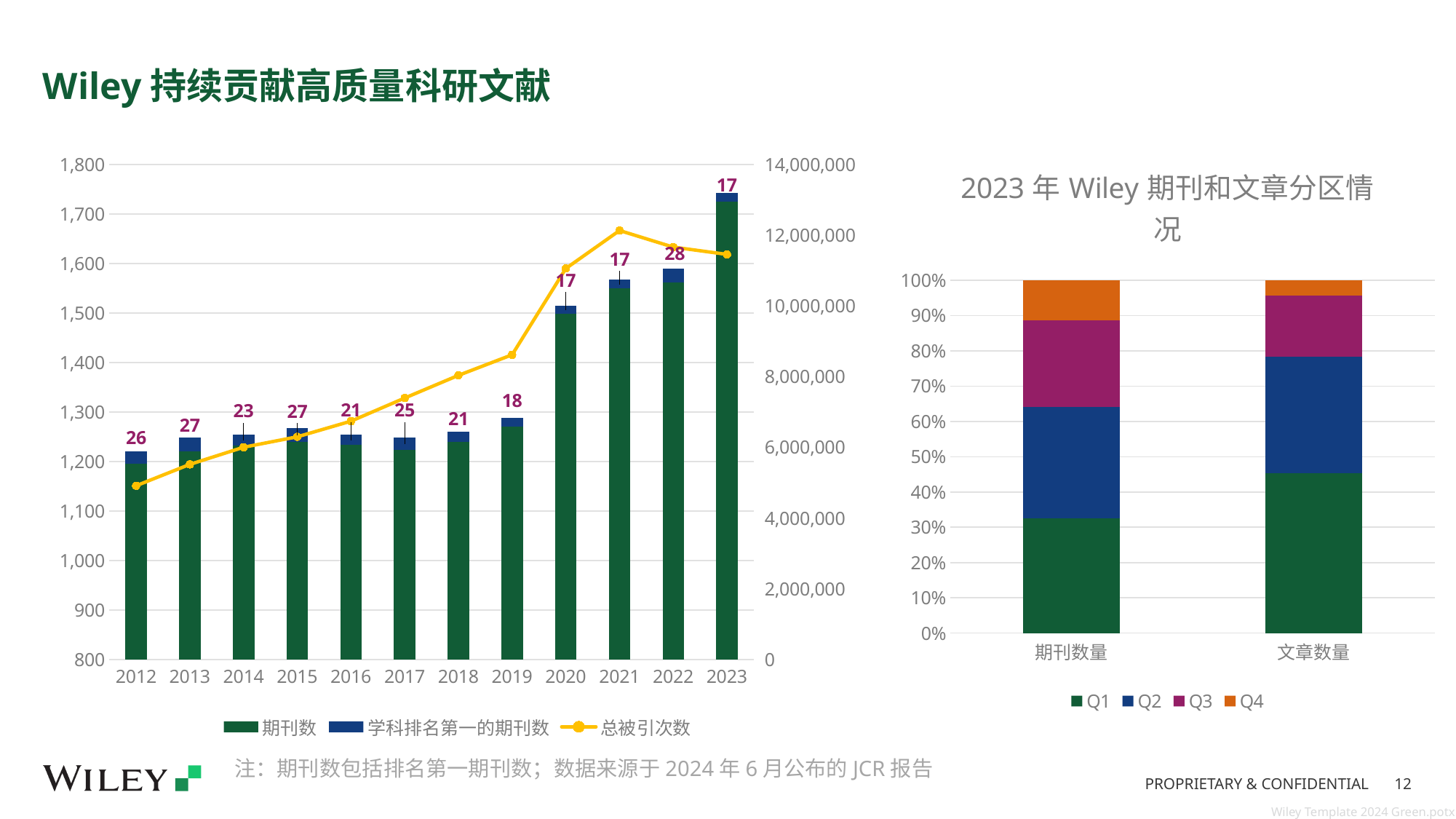
In the left chart, which year has the larger labelled value, 2013 or 2016? 2013 How many series does the legend of the left chart list? 3 In the left chart, does the 总被引次数 line generally rise or fall from 2012 to 2021? rise In the left chart, what is the data label shown for 2022? 28 In the left chart, what is the difference between the labelled values for 2022 and 2019? 10 In the left chart, is the 总被引次数 value for 2012 greater or less than 6,000,000? less In the left chart, which year has the highest labelled value for 学科排名第一的期刊数? 2022 In the right chart, is the Q1 share of 文章数量 greater or less than 40%? greater In the left chart, what is the data label shown for 2012? 26 How many years are shown on the x axis of the left chart? 12 In the left chart, is the total bar height for 2012 greater or less than 1,300? less What is the title of the chart on the right? 2023 年 Wiley 期刊和文章分区情况